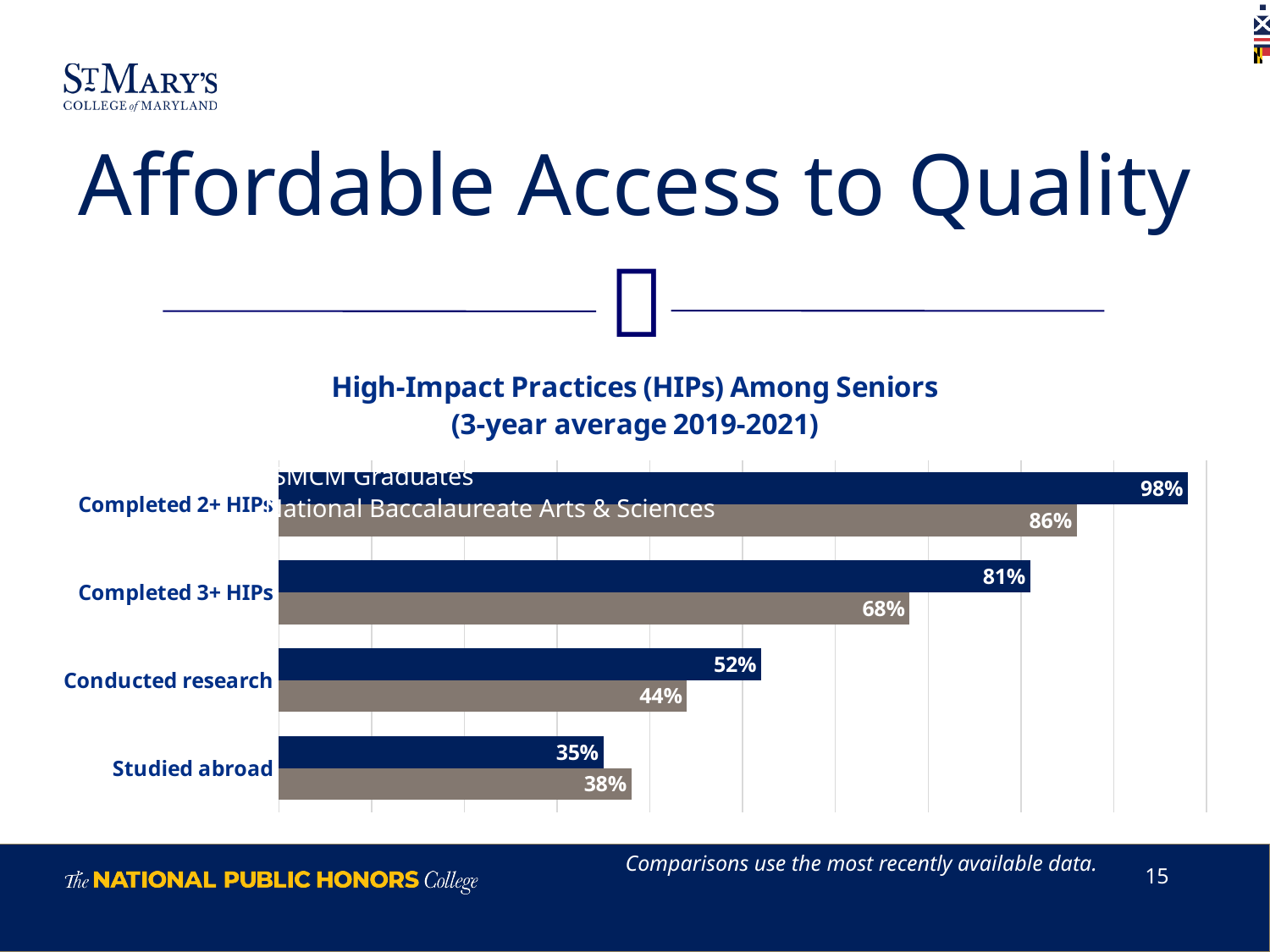
For Studied abroad, which is larger: the SMCM Graduates value or the National Baccalaureate Arts & Sciences value? National Baccalaureate Arts & Sciences What is the SMCM Graduates value for Conducted research? 52% What is the National Baccalaureate Arts & Sciences value for Completed 3+ HIPs? 68% Which category has the lowest National Baccalaureate Arts & Sciences value? Studied abroad What is the SMCM Graduates value for Completed 2+ HIPs? 98% What is the National Baccalaureate Arts & Sciences value for Studied abroad? 38% How many series does the legend list? 2 Which category has the highest SMCM Graduates value? Completed 2+ HIPs What kind of chart is shown on the slide? Bar chart What is the title of the chart? High-Impact Practices (HIPs) Among Seniors (3-year average 2019-2021) What is the difference between the SMCM Graduates and National Baccalaureate Arts & Sciences values for Completed 3+ HIPs? 13% How many categories are shown on the chart? 4